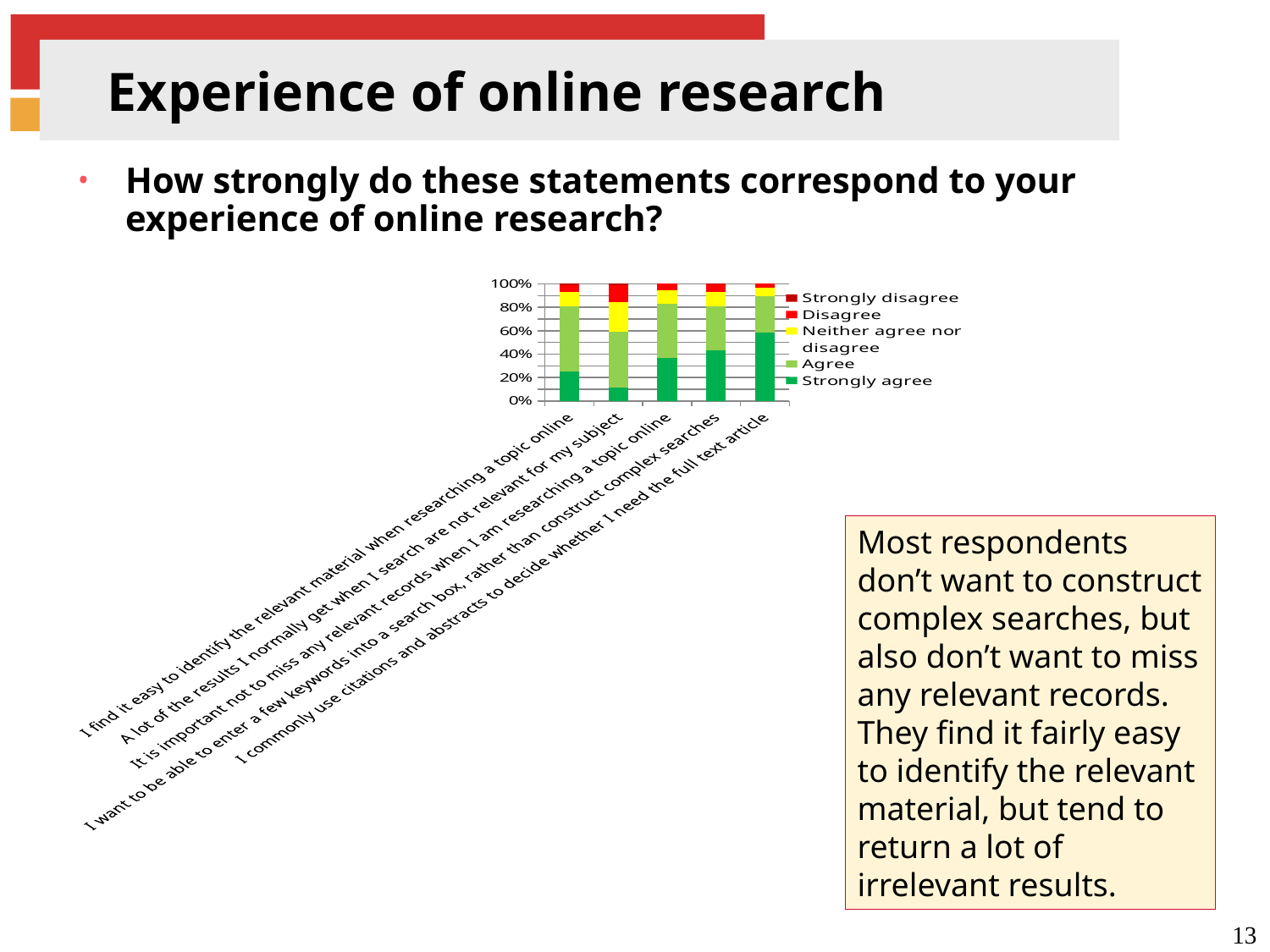
Which statement has the largest 'Neither agree nor disagree' share? A lot of the results I normally get when I search are not relevant for my subject What kind of chart is shown on the slide? Stacked bar chart Which has the larger 'Strongly agree' share: 'I commonly use citations and abstracts to decide whether I need the full text article' or 'I find it easy to identify the relevant material when researching a topic online'? I commonly use citations and abstracts to decide whether I need the full text article Which statement has the largest 'Strongly agree' share? I commonly use citations and abstracts to decide whether I need the full text article What does each stacked bar in the chart total? 100% Is the 'Strongly agree' share for 'I commonly use citations and abstracts to decide whether I need the full text article' greater or less than 40%? greater Is the 'Strongly agree' share for 'A lot of the results I normally get when I search are not relevant for my subject' greater or less than 20%? less Which series is listed first (at the top) in the chart's legend? Strongly disagree How many series does the chart's legend list? 5 How many statements (categories) are plotted on the x axis of the chart? 5 Is the 'Strongly agree' share for 'I find it easy to identify the relevant material when researching a topic online' greater or less than 40%? less Which statement has the smallest 'Strongly agree' share? A lot of the results I normally get when I search are not relevant for my subject